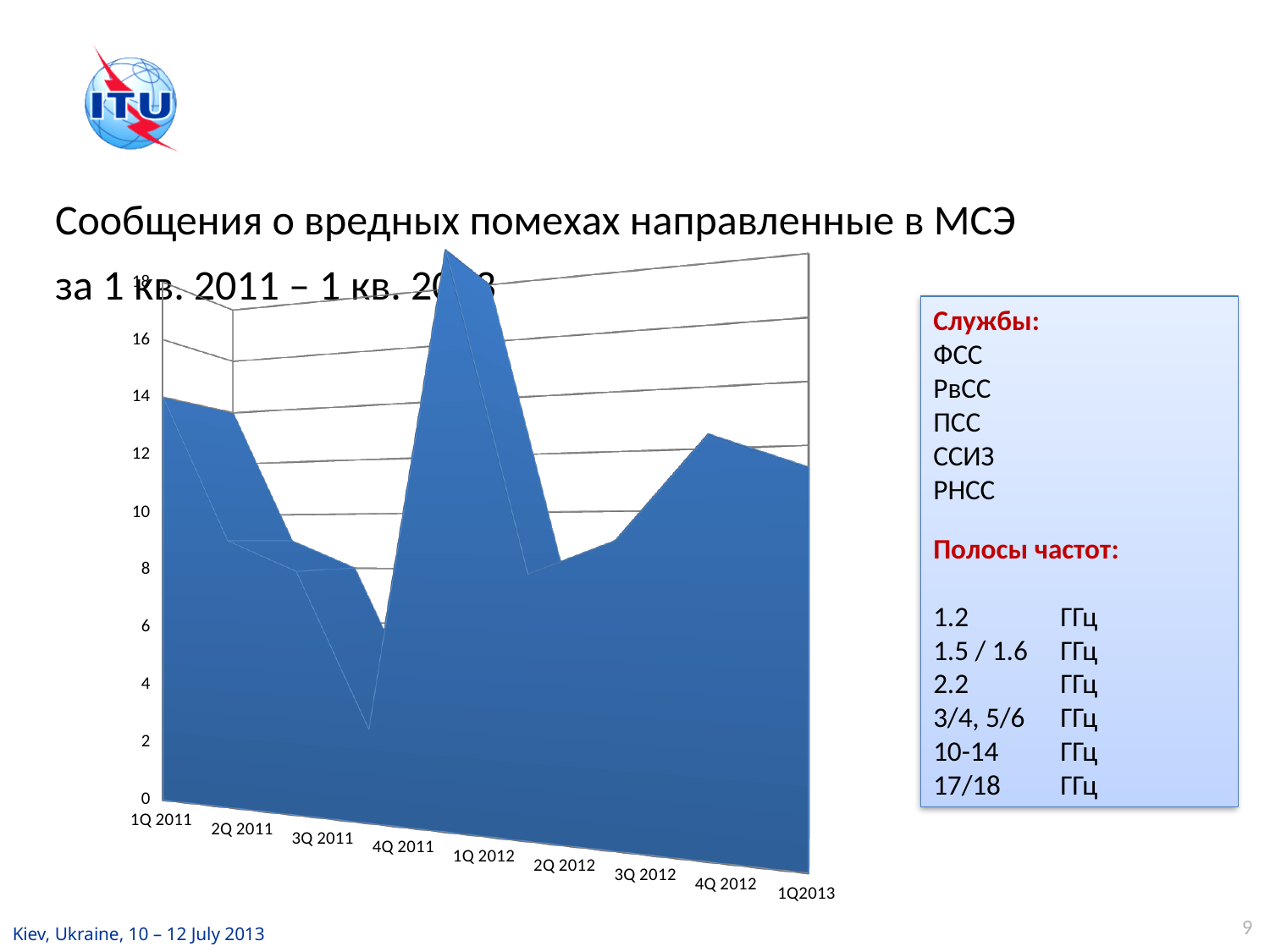
Which is larger, the value for 1Q 2011 or the value for 2Q 2011? 1Q 2011 What kind of chart is shown on the slide? area chart Which is larger, the value for 4Q 2012 or the value for 2Q 2012? 4Q 2012 Which quarter has the highest value in the chart? 1Q 2012 Which quarter has the lowest value in the chart? 4Q 2011 Is the value for 1Q 2011 greater or less than 10? greater What is the first quarter label on the x axis of the chart? 1Q 2011 Is the value for 1Q 2012 greater or less than 16? greater Is the value for 4Q 2011 greater or less than 6? less How many quarters are plotted along the x axis of the chart? 9 Do the values rise or fall from 1Q 2011 to 4Q 2011? fall